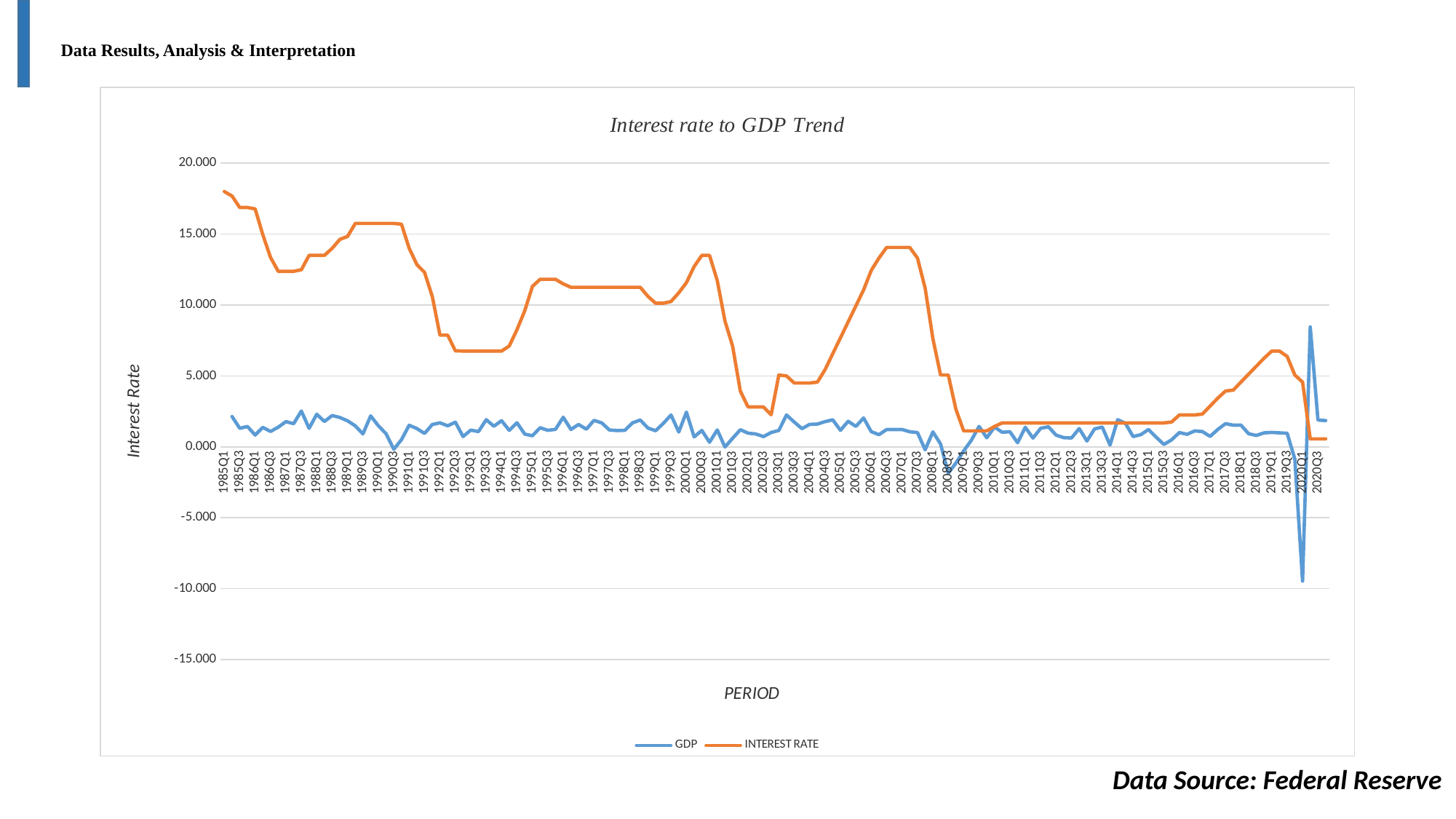
Overall, does the INTEREST RATE line rise or fall from 1985Q1 to 2020Q3? fall What kind of chart is shown on the slide? line chart Is the lowest point of the GDP line greater or less than -5.000? less At 2006Q3, which series has the higher value, GDP or INTEREST RATE? INTEREST RATE What is the title of the chart? Interest rate to GDP Trend Is the INTEREST RATE value at 2020Q3 greater or less than 5.000? less Is the INTEREST RATE value at 2006Q3 greater or less than 10.000? greater How many series does the legend of the chart list? 2 What are the two series named in the chart legend? GDP and INTEREST RATE